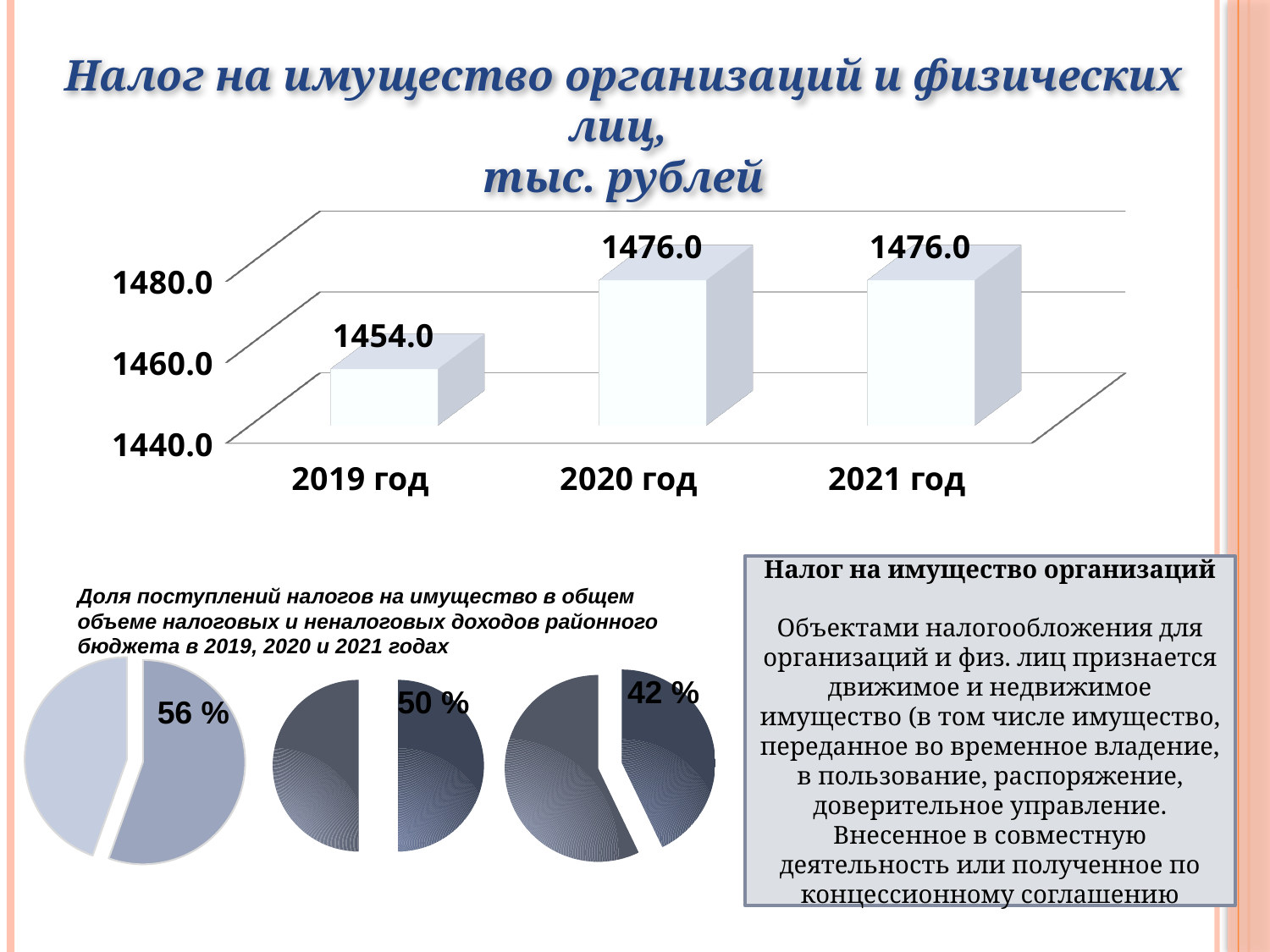
What is the unit stated in the title of the bar chart? тыс. рублей In the bar chart, is the value for 2020 год larger or smaller than the value for 2019 год? larger In the bar chart, what is the value for 2019 год? 1454.0 In the bar chart, which year has the lowest value? 2019 год How many years are shown in the bar chart? 3 In the bar chart, what is the value for 2021 год? 1476.0 In the bar chart, do the values rise or fall from 2019 год to 2020 год? rise What kind of chart is the chart at the top of the slide? bar chart In the bar chart, what is the difference between the values for 2020 год and 2019 год? 22.0 In the leftmost pie chart at the bottom of the slide, what share is labelled on the highlighted slice? 56 % In the bar chart, is the value for 2019 год greater or less than 1460.0? less In the bar chart, what is the value for 2020 год? 1476.0